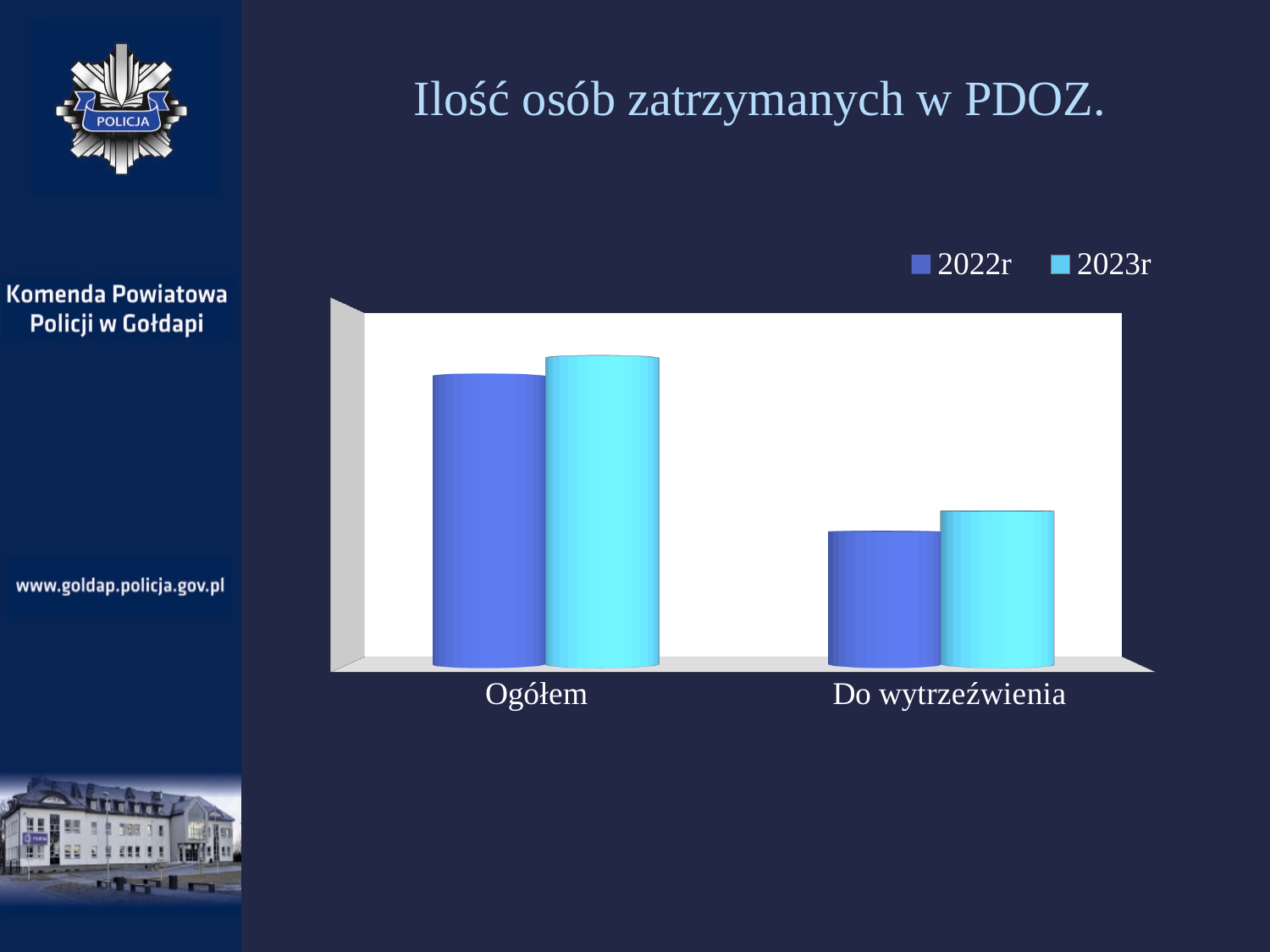
Which category has the highest value in the 2023r series? Ogółem For the category Do wytrzeźwienia, which series has the larger value, 2022r or 2023r? 2023r Do the values for the 2022r series rise or fall from Ogółem to Do wytrzeźwienia? fall How many categories are shown on the x axis? 2 Which category has the lowest value in the 2022r series? Do wytrzeźwienia What kind of chart is shown on the slide? bar chart For the category Ogółem, which series has the larger value, 2022r or 2023r? 2023r For the 2022r series, which category has the larger value, Ogółem or Do wytrzeźwienia? Ogółem Which series are listed in the legend? 2022r and 2023r How many series does the legend list? 2 What is the title of the chart? Ilość osób zatrzymanych w PDOZ.